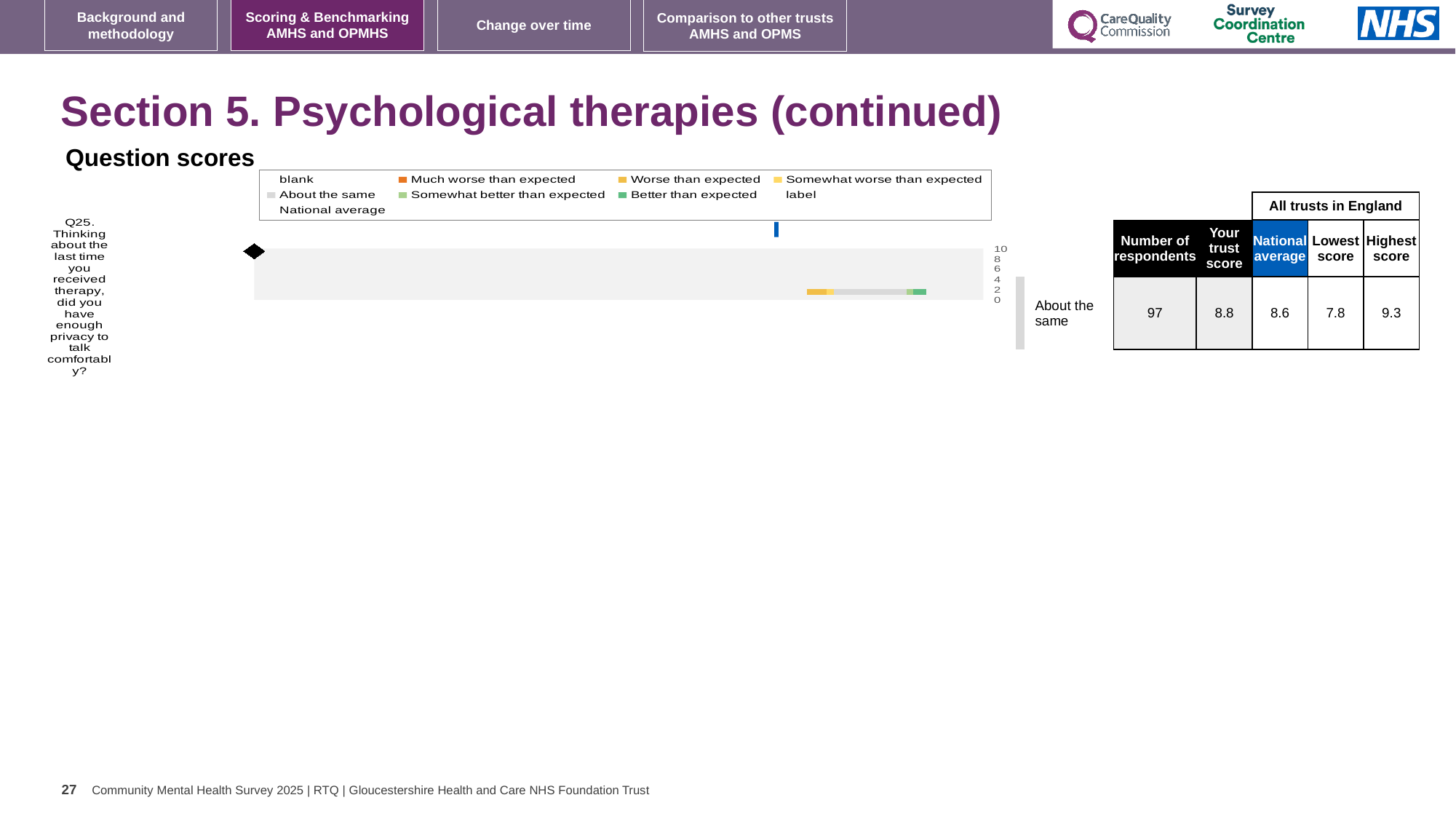
In the table beside the chart, what is the trust's score for Q25? 8.8 According to the label to the right of the chart, how does the trust's score for Q25 compare with expectations? About the same How many questions (categories) are plotted in the chart? 1 In the table beside the chart, what is the lowest score among all trusts in England for Q25? 7.8 What kind of chart is shown under 'Question scores'? bar chart In the table beside the chart, what is the national average for Q25? 8.6 What is the highest tick value shown on the chart's axis? 10 In the table beside the chart, how many respondents answered Q25? 97 In the table beside the chart, what is the highest score among all trusts in England for Q25? 9.3 Which question number is plotted in the chart? Q25 Is the trust's score for Q25 larger or smaller than the national average? larger What is the difference between the highest score and the lowest score for Q25 in the table beside the chart? 1.5